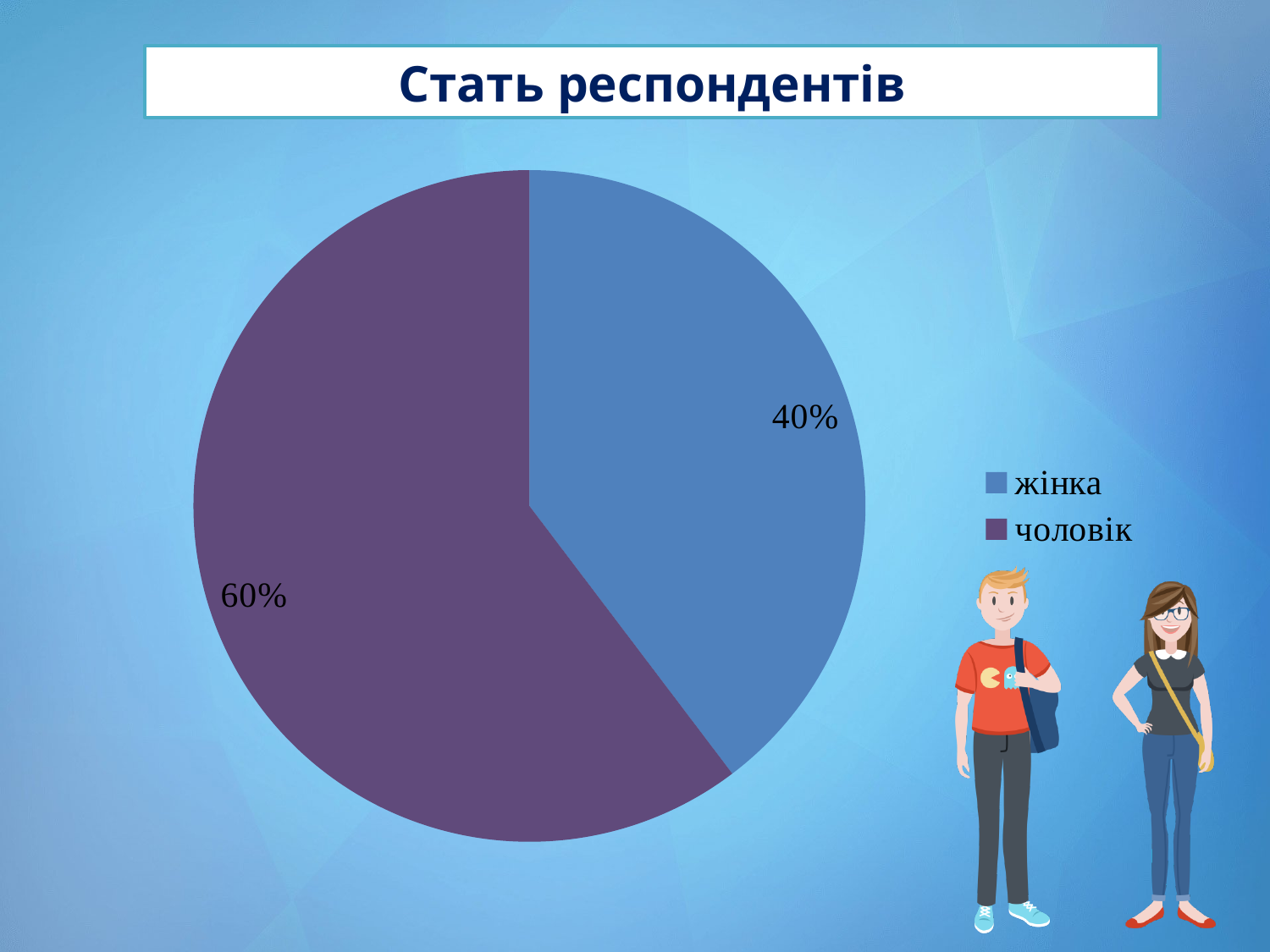
How many entries does the legend list? 2 What is the title of the chart? Стать респондентів What colour is the slice for "чоловік"? purple Which is larger, the share for "жінка" or for "чоловік"? чоловік Which category has the largest share of the pie? чоловік Which category has the smallest share of the pie? жінка How many slices does the pie chart have? 2 What kind of chart is shown on the slide? pie chart Is the share for "жінка" greater or less than 50%? less What share of respondents are "жінка"? 40% What is the difference in percentage points between the "чоловік" and "жінка" shares? 20% What share of respondents are "чоловік"? 60%